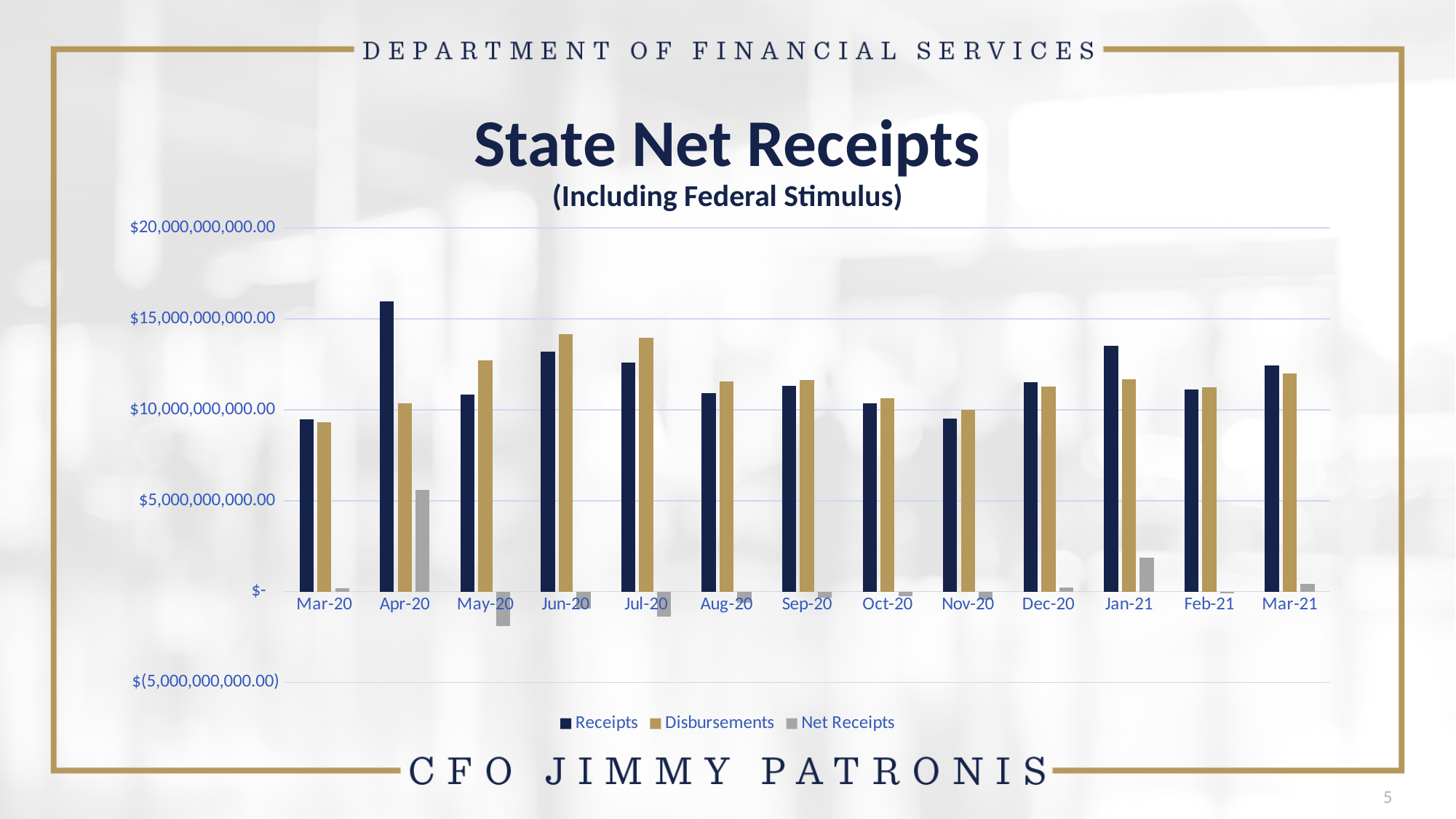
Which month has the lowest Net Receipts value? May-20 What kind of chart is shown on the slide? Bar chart How many months are shown on the x axis? 13 Is the Net Receipts value for Apr-20 greater or less than $5,000,000,000.00? greater Which month has the lowest Disbursements value? Mar-20 How many series does the legend list? 3 Is the Receipts value for Apr-20 greater or less than $15,000,000,000.00? greater Which month has the highest Receipts value? Apr-20 In May-20, which is larger, Receipts or Disbursements? Disbursements Is the Receipts value for Mar-20 greater or less than $10,000,000,000.00? less What is the subtitle shown under the chart title 'State Net Receipts'? (Including Federal Stimulus) Which month has the highest Net Receipts value? Apr-20